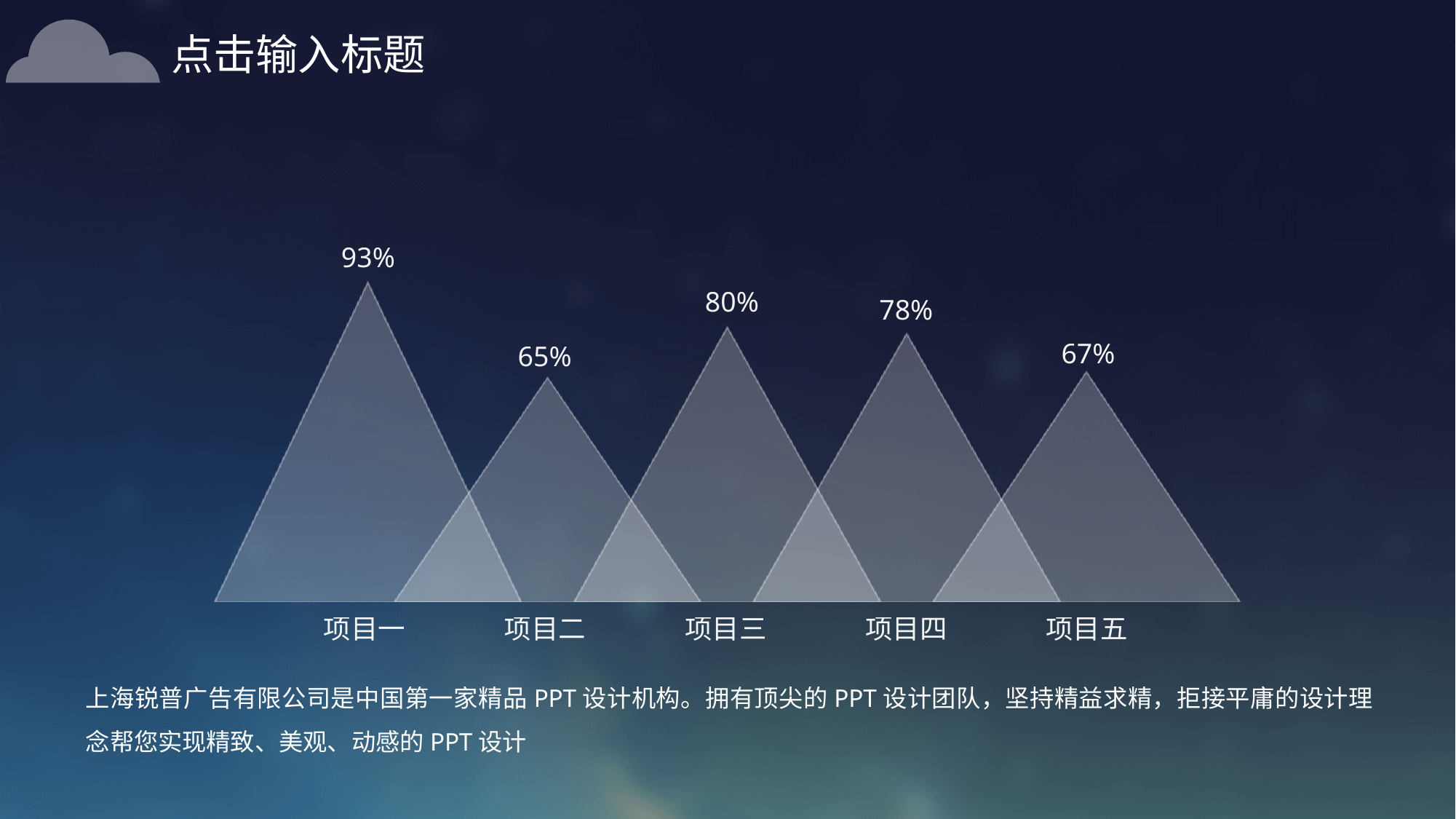
What is the value for 项目四? 78% Which category has the highest value? 项目一 What is the value for 项目五? 67% Which is larger, the value for 项目三 or the value for 项目四? 项目三 What is the difference between the values for 项目三 and 项目五? 13% What is the value for 项目三? 80% How many categories are shown in the chart? 5 What is the difference between the values for 项目一 and 项目二? 28% What is the title shown at the top of the slide? 点击输入标题 Which category has the lowest value? 项目二 What is the value for 项目二? 65% What is the value for 项目一? 93%